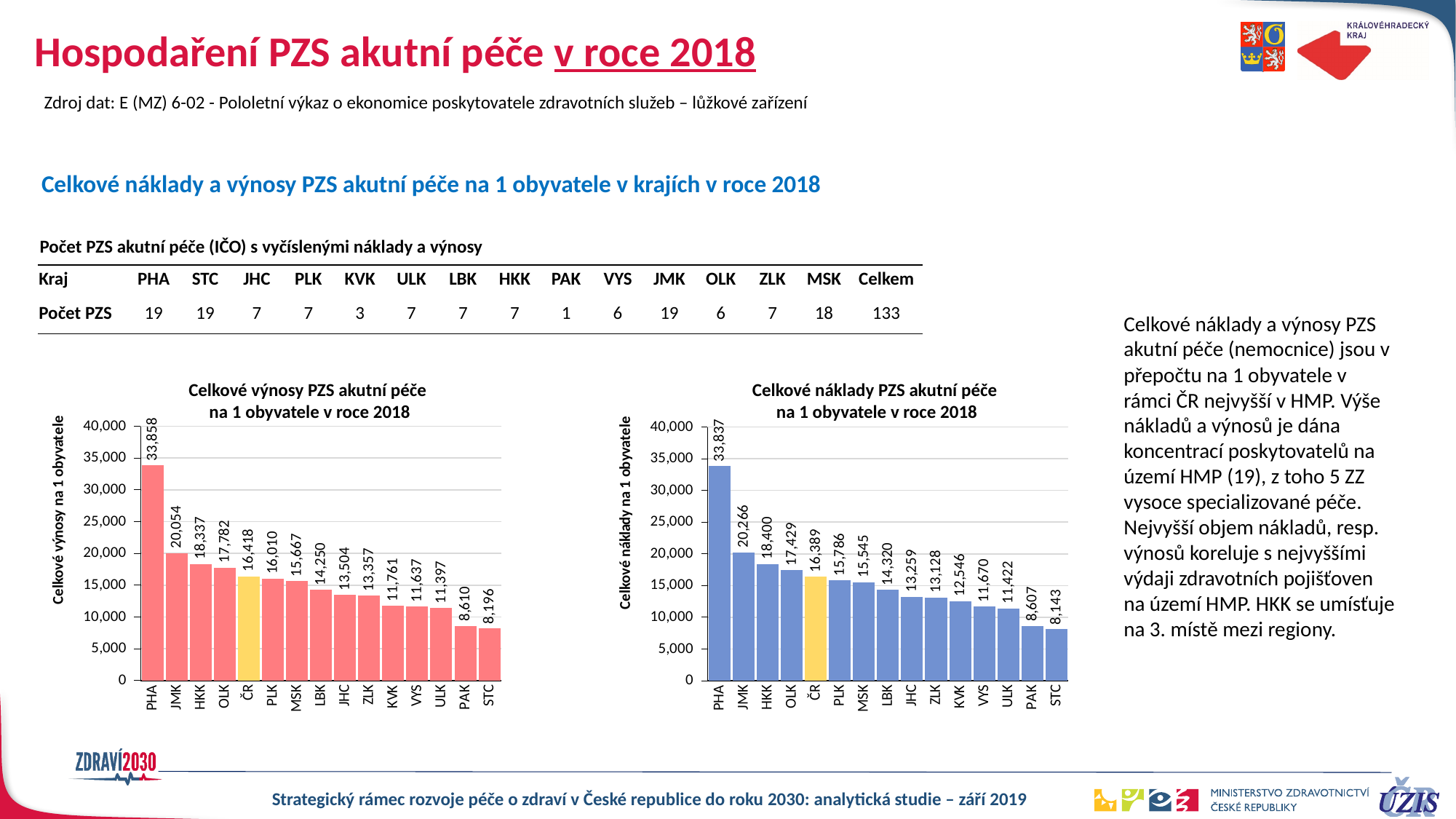
What kind of chart is 'Celkové výnosy PZS akutní péče na 1 obyvatele v roce 2018'? bar chart In the chart 'Celkové náklady PZS akutní péče na 1 obyvatele v roce 2018', which category has the highest value? PHA In the chart 'Celkové výnosy PZS akutní péče na 1 obyvatele v roce 2018', is the value for OLK greater or less than 15,000? greater In the chart 'Celkové náklady PZS akutní péče na 1 obyvatele v roce 2018', what is the value for PHA? 33,837 In the chart 'Celkové výnosy PZS akutní péče na 1 obyvatele v roce 2018', do the values rise or fall from left to right along the x axis? fall In the chart 'Celkové náklady PZS akutní péče na 1 obyvatele v roce 2018', what is the difference between the values for HKK and ČR? 2,011 In the chart 'Celkové výnosy PZS akutní péče na 1 obyvatele v roce 2018', which category has the lowest value? STC In the chart 'Celkové výnosy PZS akutní péče na 1 obyvatele v roce 2018', what is the difference between the values for PHA and JMK? 13,804 In the chart 'Celkové náklady PZS akutní péče na 1 obyvatele v roce 2018', which is larger, the value for KVK or the value for ULK? KVK In the chart 'Celkové výnosy PZS akutní péče na 1 obyvatele v roce 2018', what is the value for HKK? 18,337 In the chart 'Celkové náklady PZS akutní péče na 1 obyvatele v roce 2018', which category's bar is coloured yellow instead of blue? ČR How many categories are shown on the x axis of the chart 'Celkové náklady PZS akutní péče na 1 obyvatele v roce 2018'? 15